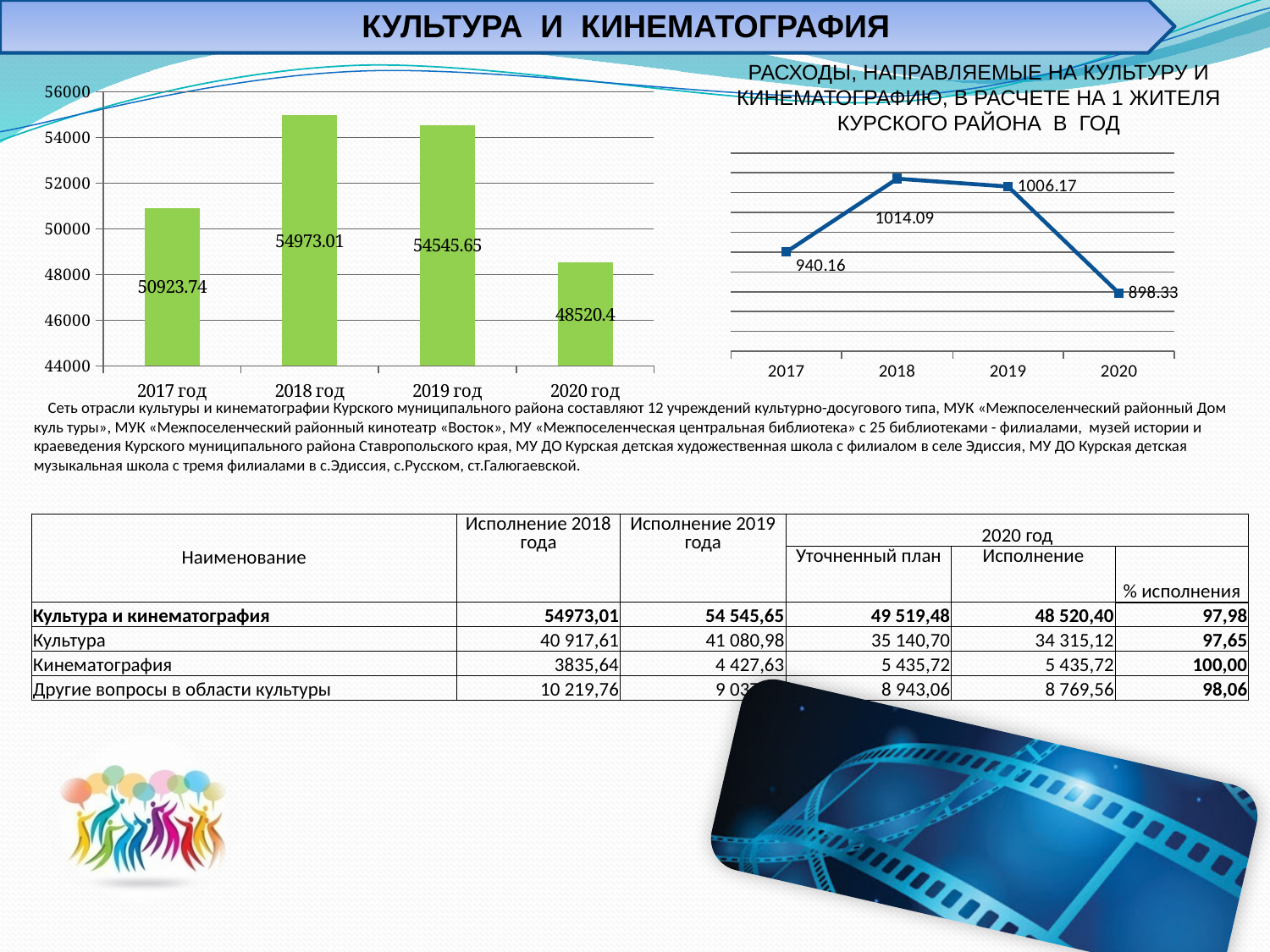
In the bar chart on the left of the slide, what is the value for 2018 год? 54973.01 In the bar chart on the left of the slide, what is the value for 2020 год? 48520.4 In the chart titled 'РАСХОДЫ, НАПРАВЛЯЕМЫЕ НА КУЛЬТУРУ И КИНЕМАТОГРАФИЮ, В РАСЧЕТЕ НА 1 ЖИТЕЛЯ КУРСКОГО РАЙОНА В ГОД', which is larger, the value for 2017 or the value for 2020? 2017 In the bar chart on the left of the slide, which year has the lowest value? 2020 год What kind of chart is the chart on the left of the slide? bar chart In the bar chart on the left of the slide, which year has the highest value? 2018 год In the bar chart on the left of the slide, is the value for 2017 год greater or less than 50000? greater In the chart titled 'РАСХОДЫ, НАПРАВЛЯЕМЫЕ НА КУЛЬТУРУ И КИНЕМАТОГРАФИЮ, В РАСЧЕТЕ НА 1 ЖИТЕЛЯ КУРСКОГО РАЙОНА В ГОД', which year has the lowest value? 2020 In the chart titled 'РАСХОДЫ, НАПРАВЛЯЕМЫЕ НА КУЛЬТУРУ И КИНЕМАТОГРАФИЮ, В РАСЧЕТЕ НА 1 ЖИТЕЛЯ КУРСКОГО РАЙОНА В ГОД', what is the value for 2018? 1014.09 In the bar chart on the left of the slide, how many bars are plotted? 4 What kind of chart is the chart titled 'РАСХОДЫ, НАПРАВЛЯЕМЫЕ НА КУЛЬТУРУ И КИНЕМАТОГРАФИЮ, В РАСЧЕТЕ НА 1 ЖИТЕЛЯ КУРСКОГО РАЙОНА В ГОД'? line chart In the bar chart on the left of the slide, what is the difference between the values for 2018 год and 2019 год? 427.36